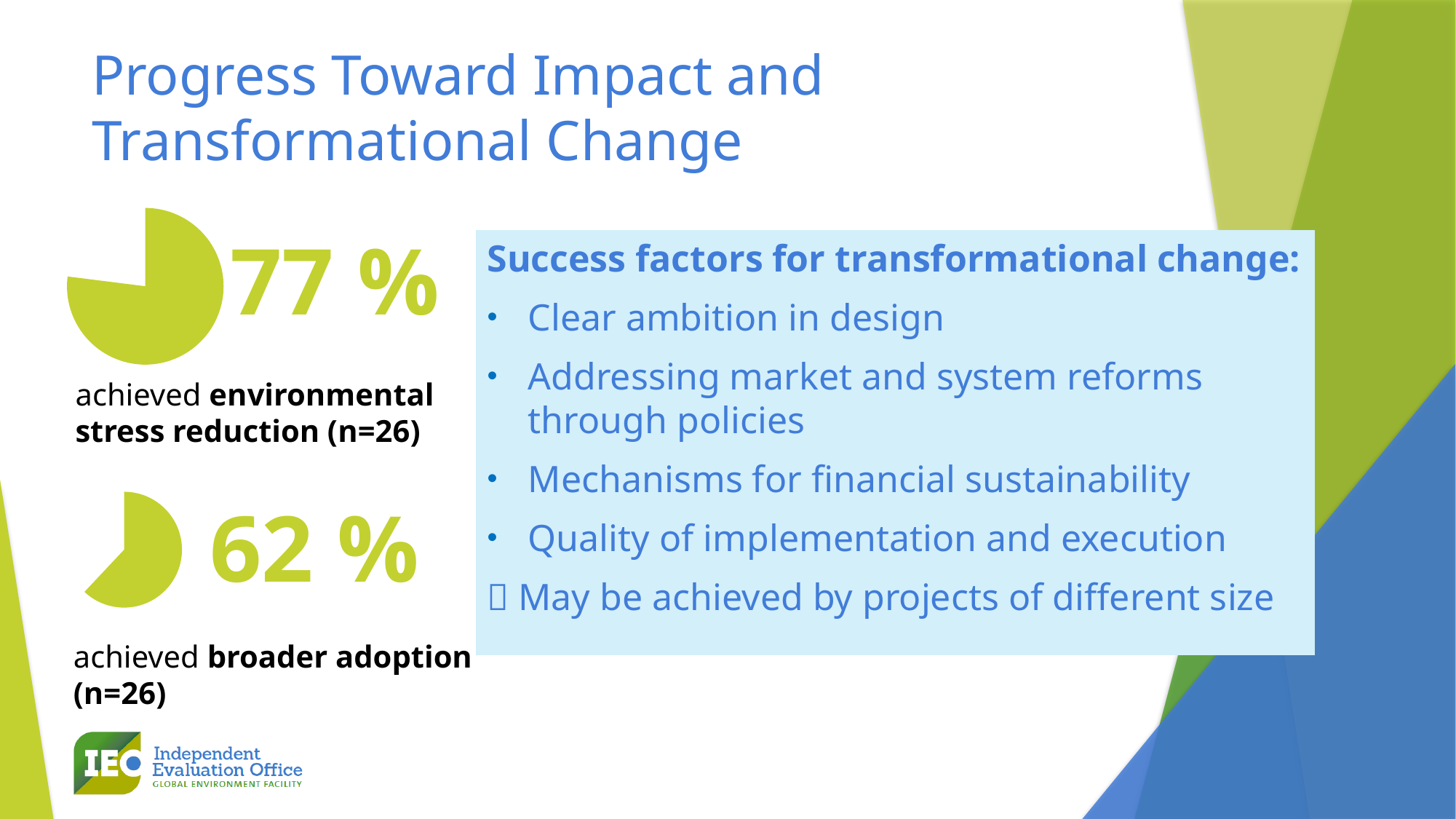
Which is larger: the share that achieved environmental stress reduction or the share that achieved broader adoption? environmental stress reduction What is the sample size (n) for the broader adoption pie chart? 26 How many pie charts are shown on the slide? 2 Which outcome has the lowest achievement share on the slide? broader adoption By how many percentage points does the environmental stress reduction share exceed the broader adoption share? 15 What percentage of projects achieved broader adoption, according to the lower pie chart? 62 % What is the sample size (n) for the environmental stress reduction pie chart? 26 What kind of chart is used to show the 77 % figure for environmental stress reduction? pie chart Which outcome has the highest achievement share on the slide? environmental stress reduction What percentage of projects achieved environmental stress reduction, according to the upper pie chart? 77 % Is the share of projects that achieved environmental stress reduction greater or less than 75 %? greater Is the share of projects that achieved broader adoption greater or less than 50 %? greater